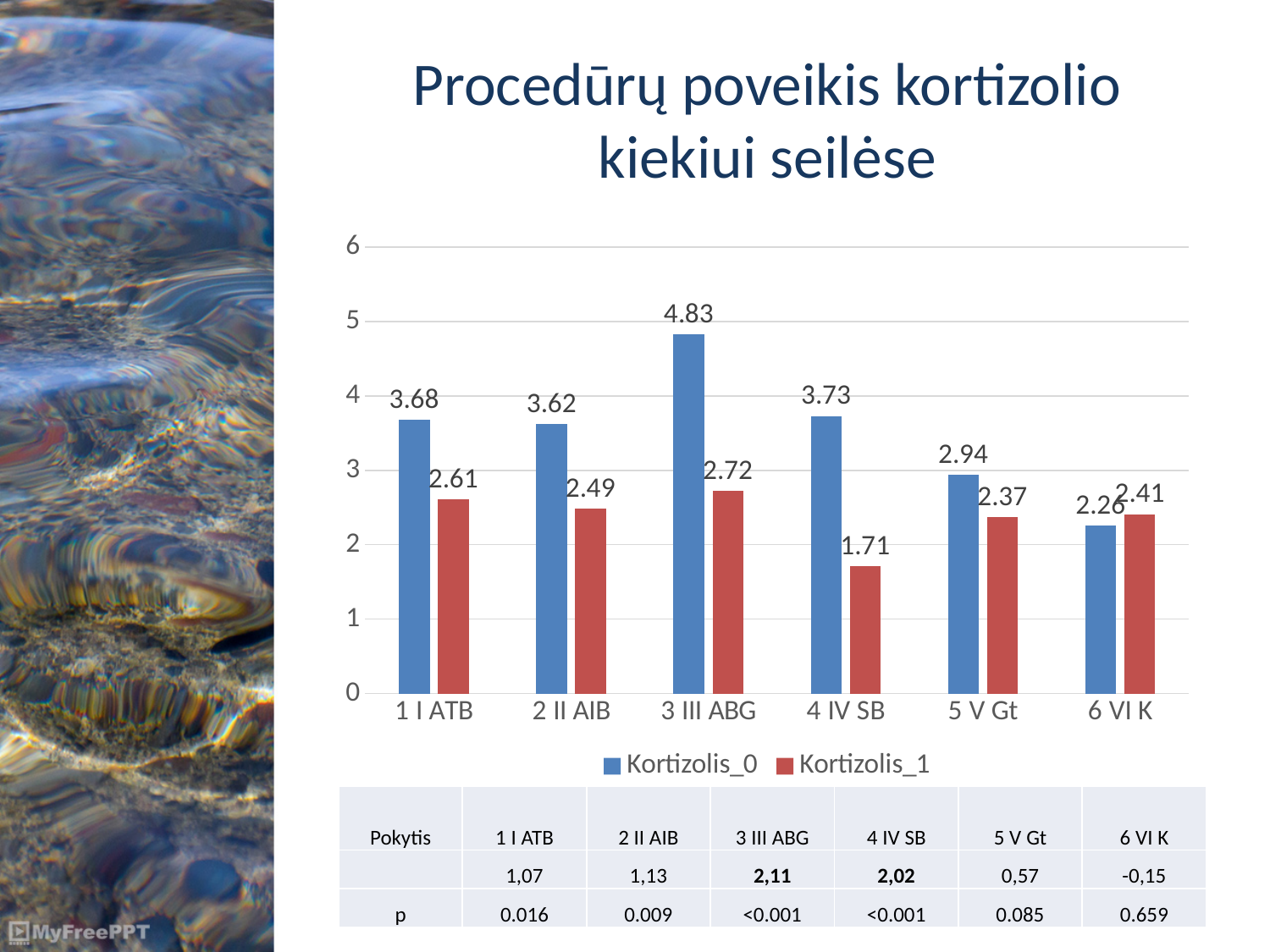
Which category has the lowest Kortizolis_1 value? 4 IV SB What is the difference between Kortizolis_0 and Kortizolis_1 for 1 I ATB? 1.07 What is the value of Kortizolis_0 for 3 III ABG? 4.83 How many series does the legend list? 2 Which category has the highest Kortizolis_0 value? 3 III ABG What is the value of Kortizolis_1 for 5 V Gt? 2.37 What is the value of Kortizolis_1 for 4 IV SB? 1.71 For 6 VI K, which is larger: Kortizolis_0 or Kortizolis_1? Kortizolis_1 How many categories are shown on the x axis? 6 What kind of chart is shown on the slide? bar chart Is the Kortizolis_0 value for 5 V Gt greater or less than 3? less What colour are the Kortizolis_1 bars? red